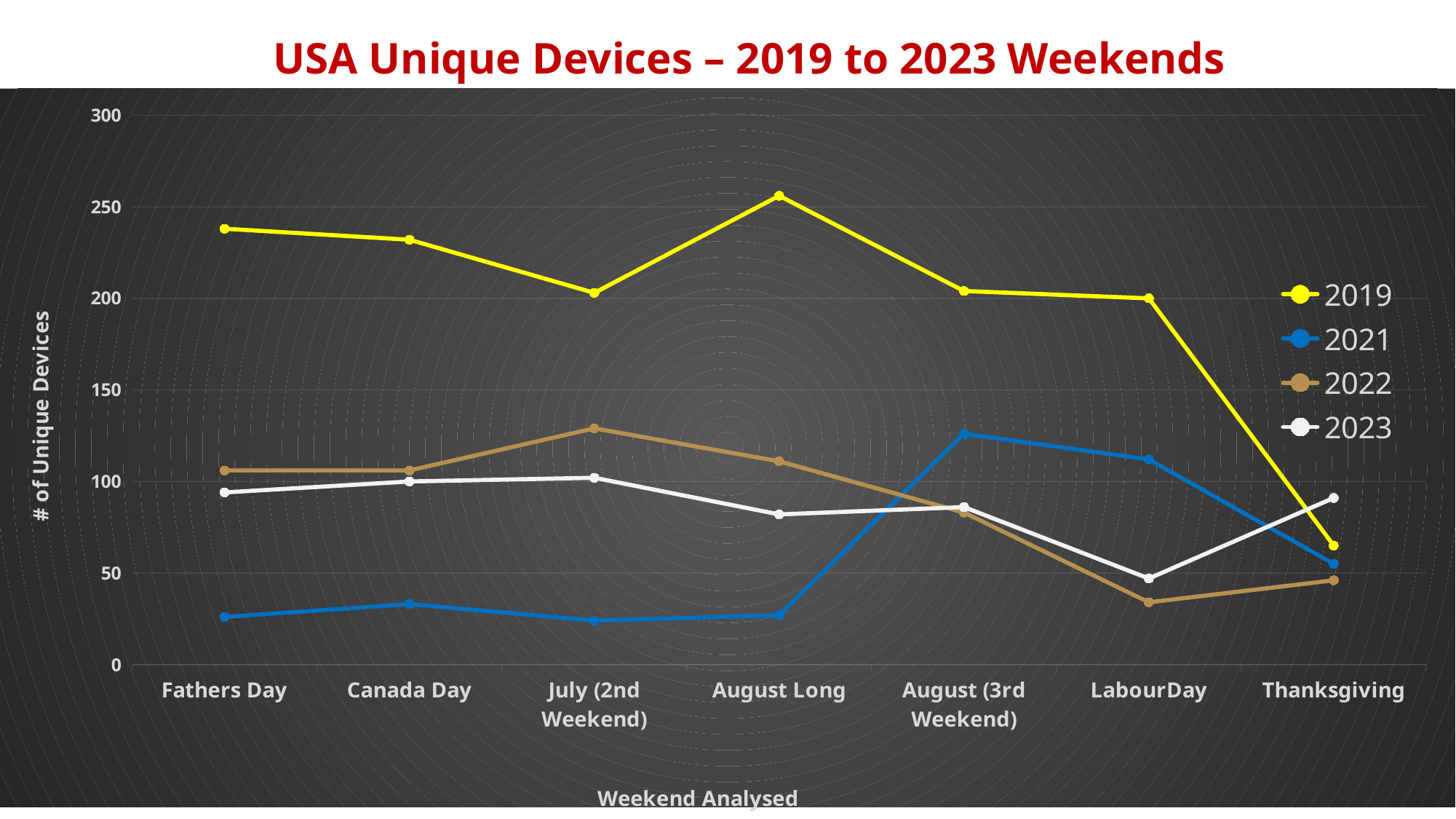
For the 2021 series, which weekend has the highest number of unique devices? August (3rd Weekend) For the 2019 series, which weekend has the lowest number of unique devices? Thanksgiving How many series does the legend list? 4 Does the 2019 line rise or fall from LabourDay to Thanksgiving? fall What kind of chart is shown on the slide? line chart Is the 2019 value for Fathers Day greater or less than 200? greater Is the 2021 value for Fathers Day greater or less than 50? less For the 2022 series, which weekend has the lowest number of unique devices? LabourDay At LabourDay, which series has the larger value, 2019 or 2021? 2019 How many weekends are plotted along the x axis? 7 For the 2019 series, which weekend has the highest number of unique devices? August Long What is the title of the vertical axis? # of Unique Devices